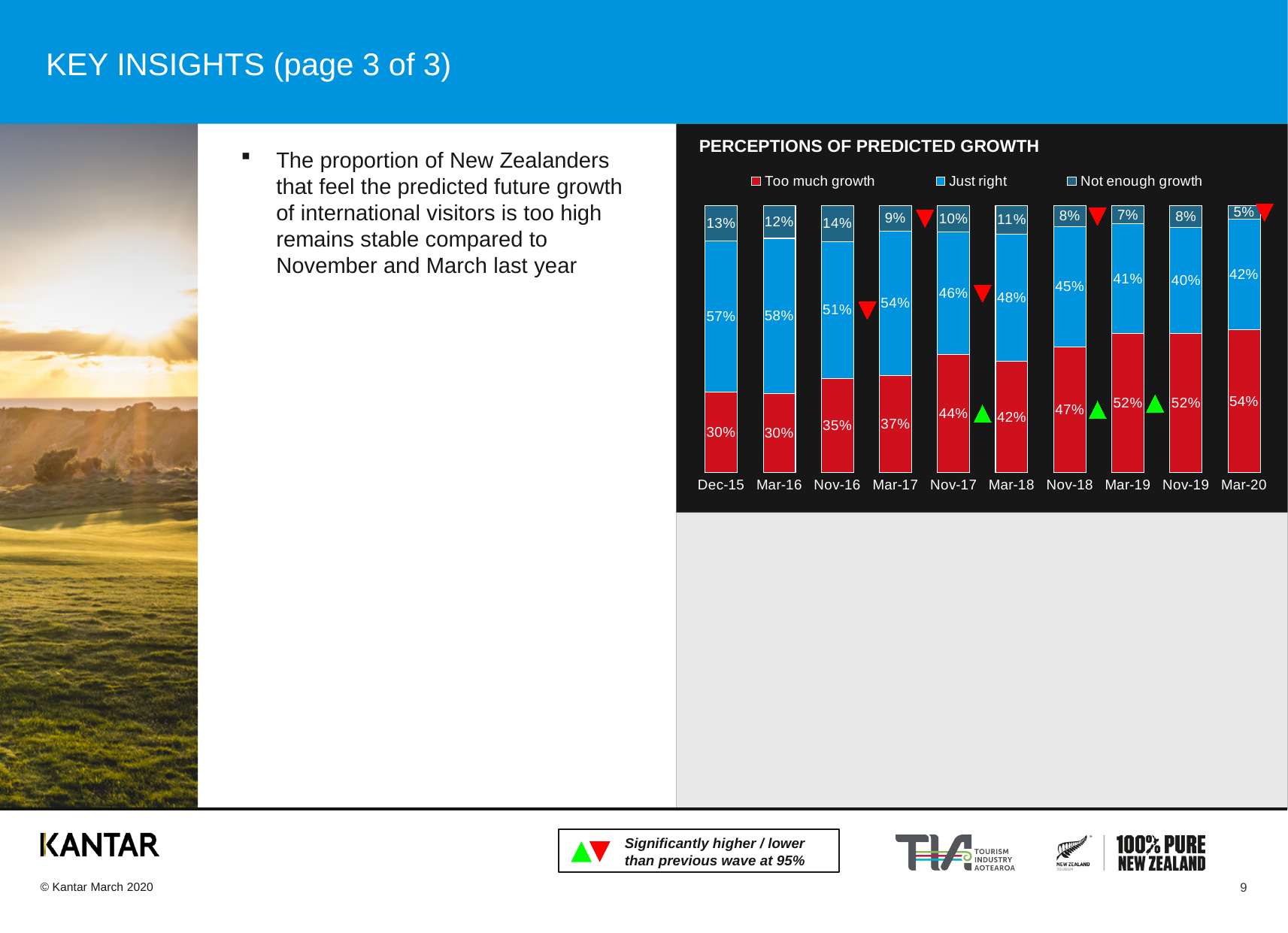
What kind of chart is shown? Stacked bar chart How many series does the legend list? 3 What is the 'Just right' value for Dec-15? 57% In which period is the 'Too much growth' share highest? Mar-20 What is the 'Not enough growth' value for Nov-16? 14% What is the title of the chart? PERCEPTIONS OF PREDICTED GROWTH What percentage of respondents said 'Too much growth' in Mar-20? 54% Does the 'Just right' share generally rise or fall from Dec-15 to Mar-20? Fall In which period is the 'Not enough growth' share lowest? Mar-20 How many time periods are shown on the x axis? 10 Which is larger in Nov-17: 'Too much growth' or 'Just right'? Just right What is the difference between the 'Too much growth' values for Mar-20 and Dec-15? 24 percentage points